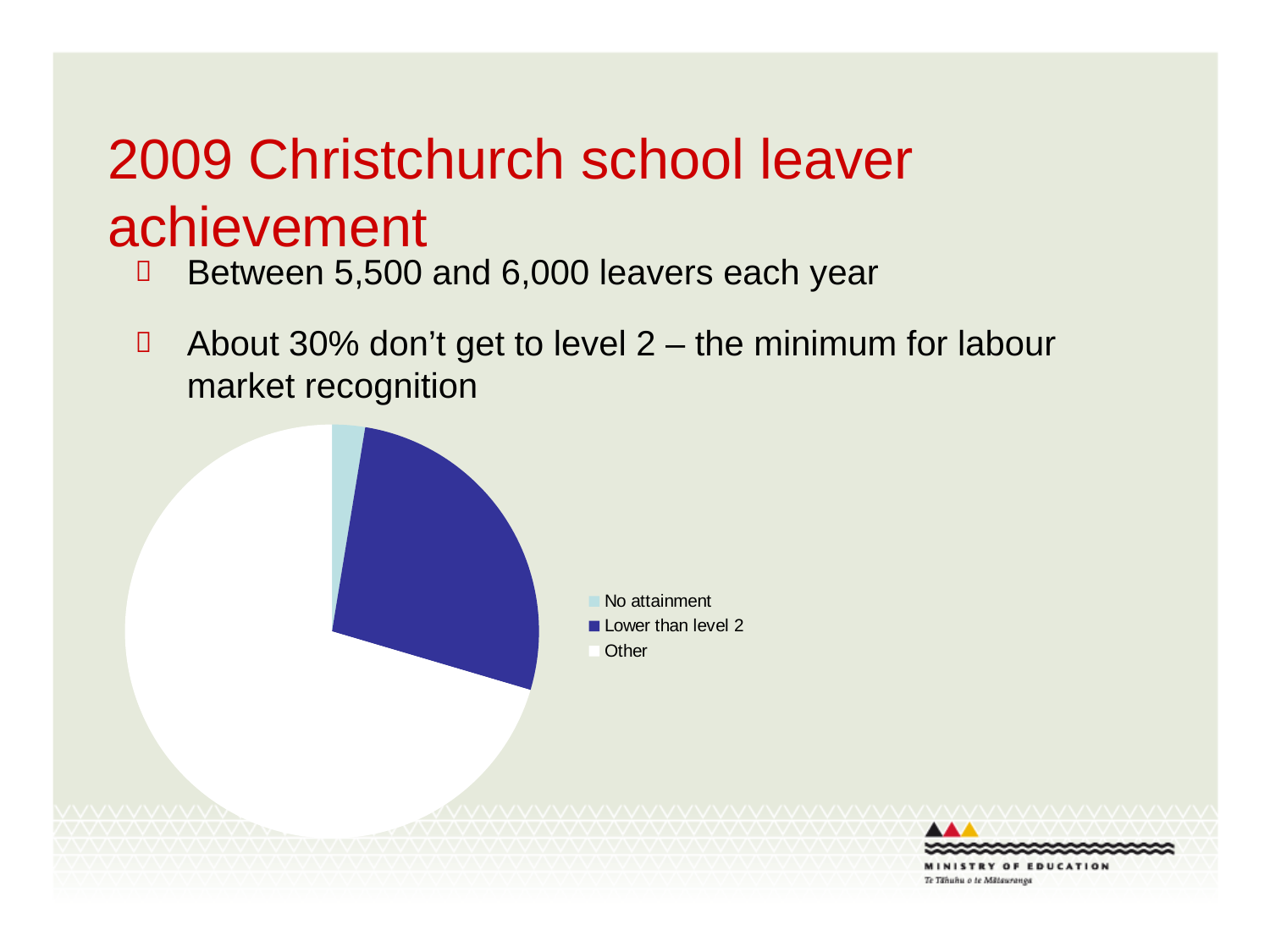
Which category has the largest slice of the pie chart? Other How many entries does the legend of the pie chart list? 3 What kind of chart is shown on the slide? Pie chart Which slice is larger in the pie chart: 'Other' or 'Lower than level 2'? Other What colour is the 'Lower than level 2' slice in the pie chart? Dark blue What are the three categories listed in the pie chart's legend? No attainment, Lower than level 2, Other Which slice is larger in the pie chart: 'Lower than level 2' or 'No attainment'? Lower than level 2 Which category has the smallest slice of the pie chart? No attainment How many slices does the pie chart have? 3